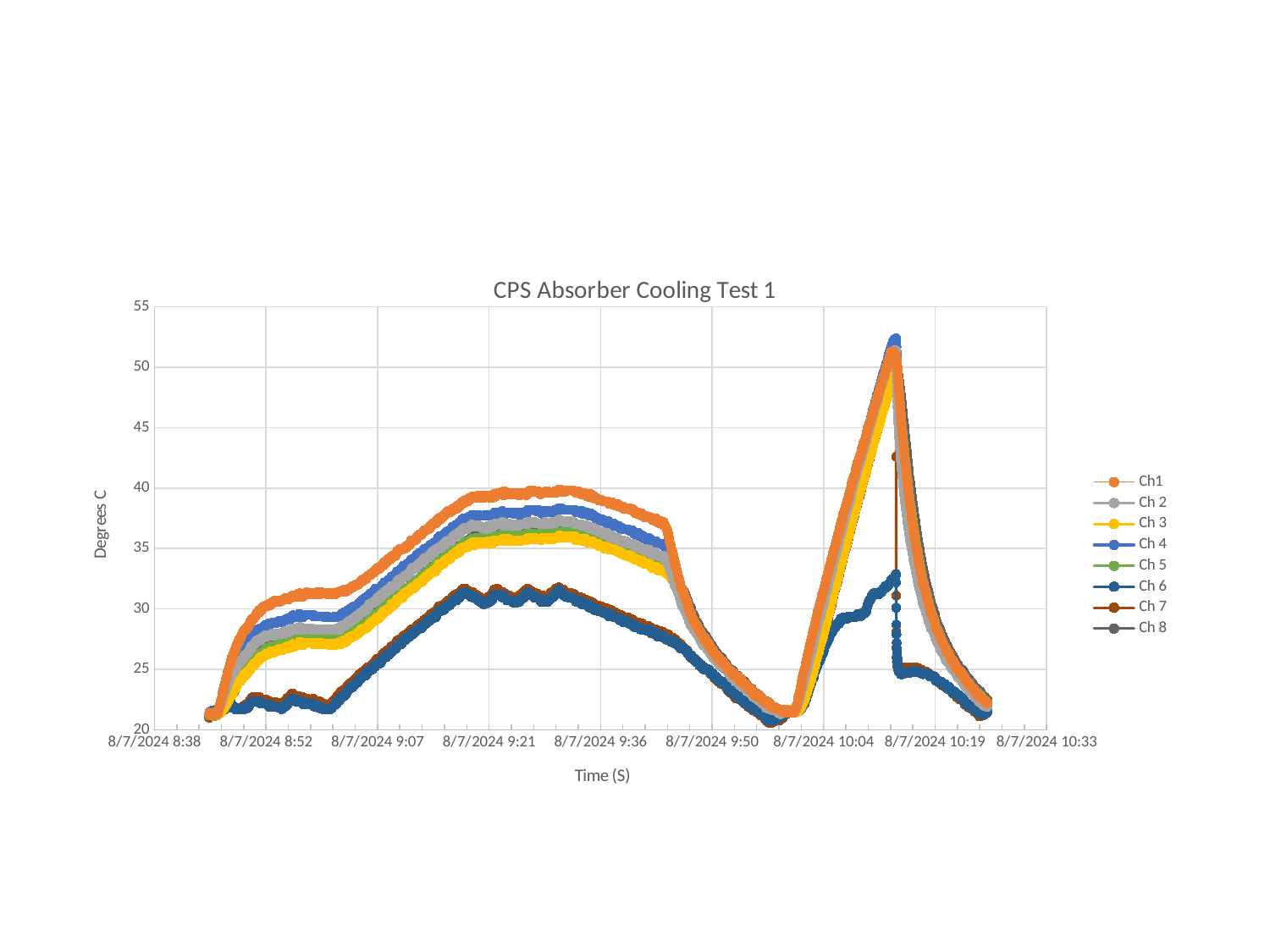
Is the peak value of Ch 6 near 8/7/2024 10:04 greater or less than 35? less Do the values rise or fall between 8/7/2024 9:50 and 8/7/2024 10:04? rise Do the values rise or fall between 8/7/2024 9:36 and 8/7/2024 9:50? fall How many series does the legend list? 8 Is the value of Ch 7 at 8/7/2024 8:52 greater or less than 25? less Is the value of Ch1 at 8/7/2024 9:21 greater or less than 35? greater What is the label of the vertical axis? Degrees C What kind of chart is shown on the slide? line chart What is the title of the chart? CPS Absorber Cooling Test 1 At 8/7/2024 9:21, which is larger, the value of Ch1 or the value of Ch 6? Ch1